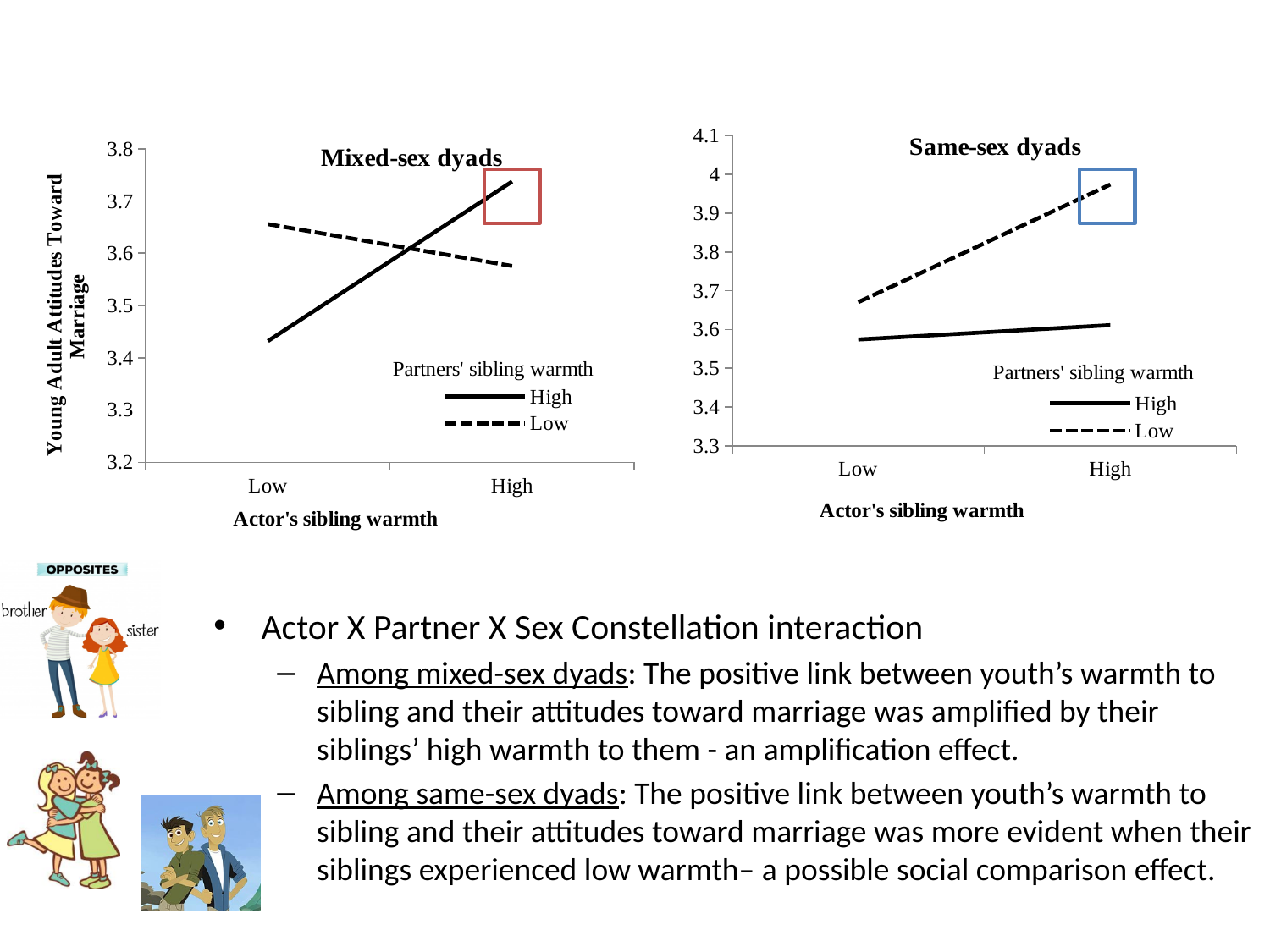
In the Mixed-sex dyads chart, is the value of the High partners' sibling warmth line at High actor's sibling warmth greater or less than 3.6? greater In the Mixed-sex dyads chart, at Low actor's sibling warmth, which partners' sibling warmth line has the higher value, High or Low? Low In the Mixed-sex dyads chart, does the Low partners' sibling warmth line rise or fall from Low to High actor's sibling warmth? fall How many categories are on the x axis of the Mixed-sex dyads chart? 2 How many series does the legend of the Same-sex dyads chart list? 2 In the Same-sex dyads chart, is the value of the Low partners' sibling warmth line at High actor's sibling warmth greater or less than 3.9? greater In the Same-sex dyads chart, is the value of the High partners' sibling warmth line at Low actor's sibling warmth greater or less than 3.7? less What kind of chart is the Mixed-sex dyads chart? line chart In the Same-sex dyads chart, does the Low partners' sibling warmth line rise or fall from Low to High actor's sibling warmth? rise In the Mixed-sex dyads chart, does the High partners' sibling warmth line rise or fall from Low to High actor's sibling warmth? rise What is the label of the y axis on the Mixed-sex dyads chart? Young Adult Attitudes Toward Marriage